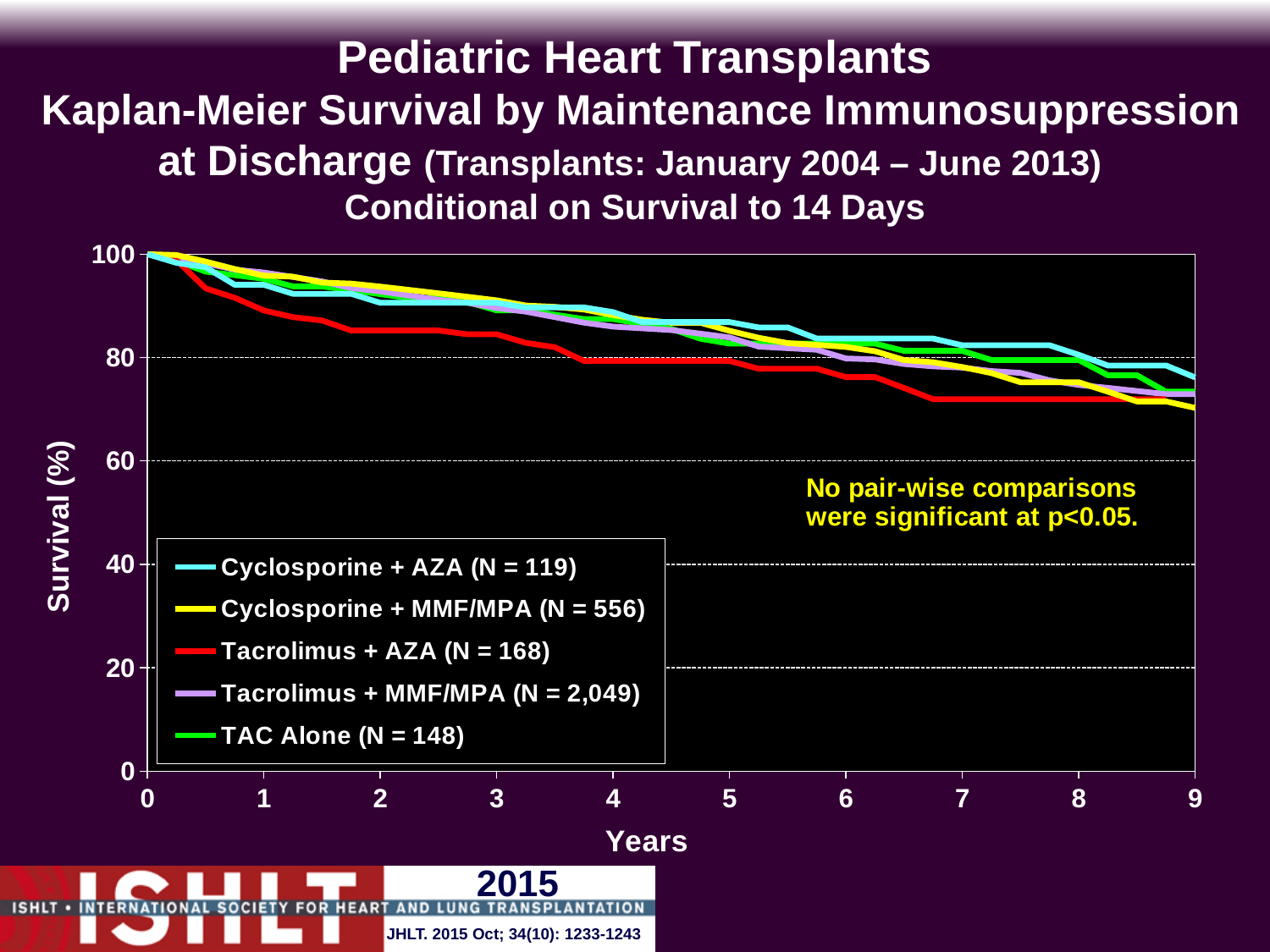
How many series does the legend list? 5 Is the survival value for Cyclosporine + MMF/MPA at 9 years greater or less than 60? greater Is the survival value for Tacrolimus + MMF/MPA at 2 years greater or less than 80? greater What kind of chart is shown on the slide? line chart Do the survival curves rise or fall as the years increase along the x axis? fall What is the label of the y axis? Survival (%) What is the N shown in the legend for Tacrolimus + MMF/MPA? 2,049 At 2 years, which series has higher survival: Tacrolimus + AZA or Cyclosporine + MMF/MPA? Cyclosporine + MMF/MPA Is the survival value for Tacrolimus + AZA at 7 years greater or less than 80? less At 3 years, which series has higher survival: Cyclosporine + AZA or Tacrolimus + AZA? Cyclosporine + AZA Which series has the lowest survival at 7 years? Tacrolimus + AZA